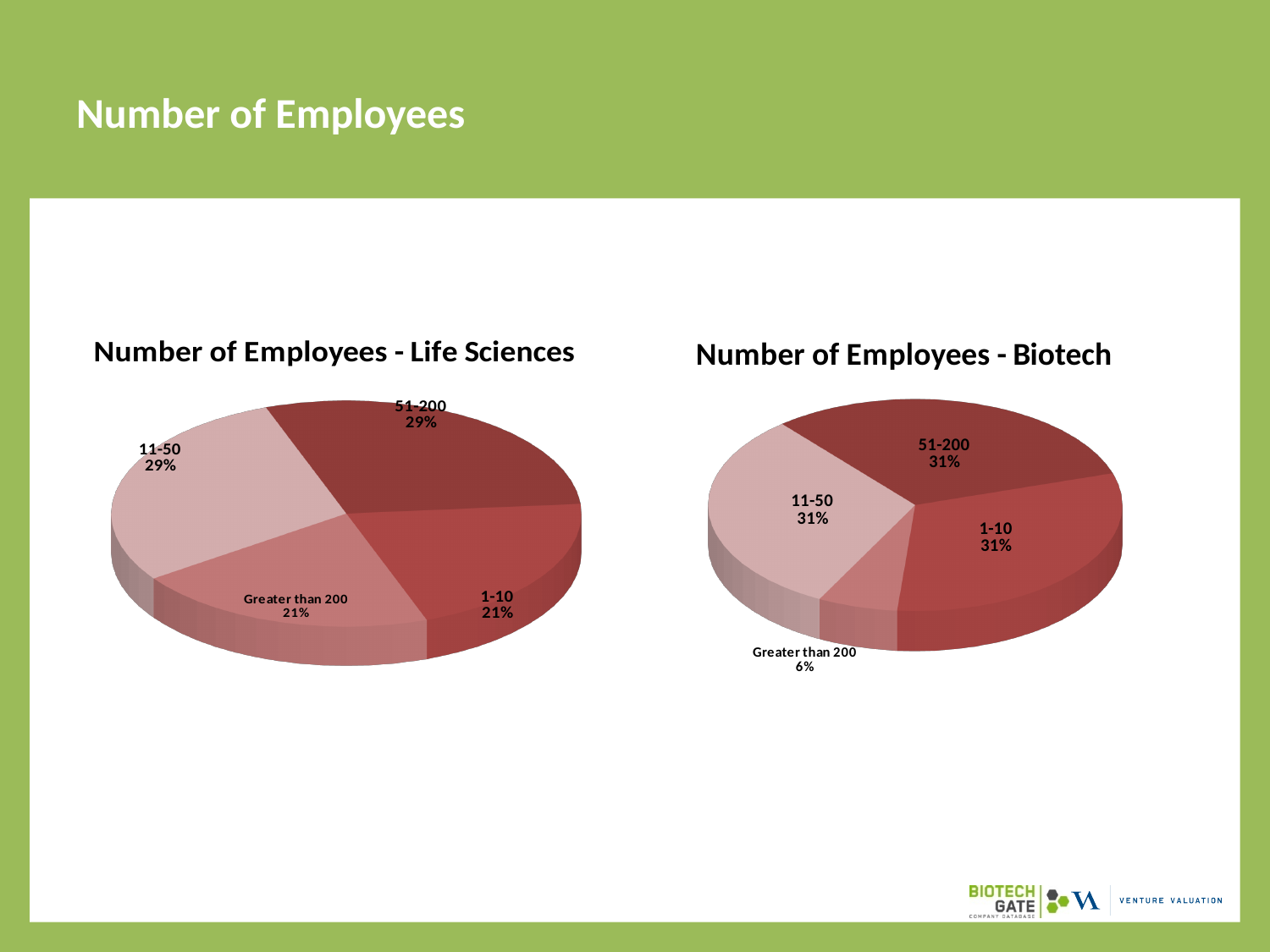
How many categories are shown in the 'Number of Employees - Biotech' chart? 4 In the 'Number of Employees - Life Sciences' chart, what is the difference in percentage points between the 11-50 slice and the 'Greater than 200' slice? 8 percentage points In the 'Number of Employees - Life Sciences' chart, what percentage is shown for the 'Greater than 200' category? 21% In the 'Number of Employees - Biotech' chart, what is the difference in percentage points between the 1-10 slice and the 'Greater than 200' slice? 25 percentage points In the 'Number of Employees - Life Sciences' chart, what share of the pie is the 51-200 slice? 29% What type of chart is the 'Number of Employees - Life Sciences' chart? Pie chart In the 'Number of Employees - Biotech' chart, which category has the smallest share? Greater than 200 In the 'Number of Employees - Biotech' chart, what share of the pie is the 'Greater than 200' slice? 6% In the 'Number of Employees - Life Sciences' chart, which is larger: the 51-200 slice or the 1-10 slice? 51-200 In the 'Number of Employees - Biotech' chart, which is larger: the 11-50 slice or the 'Greater than 200' slice? 11-50 What is the title of the chart on the right side of the slide? Number of Employees - Biotech In the 'Number of Employees - Biotech' chart, what percentage is shown for the 1-10 category? 31%